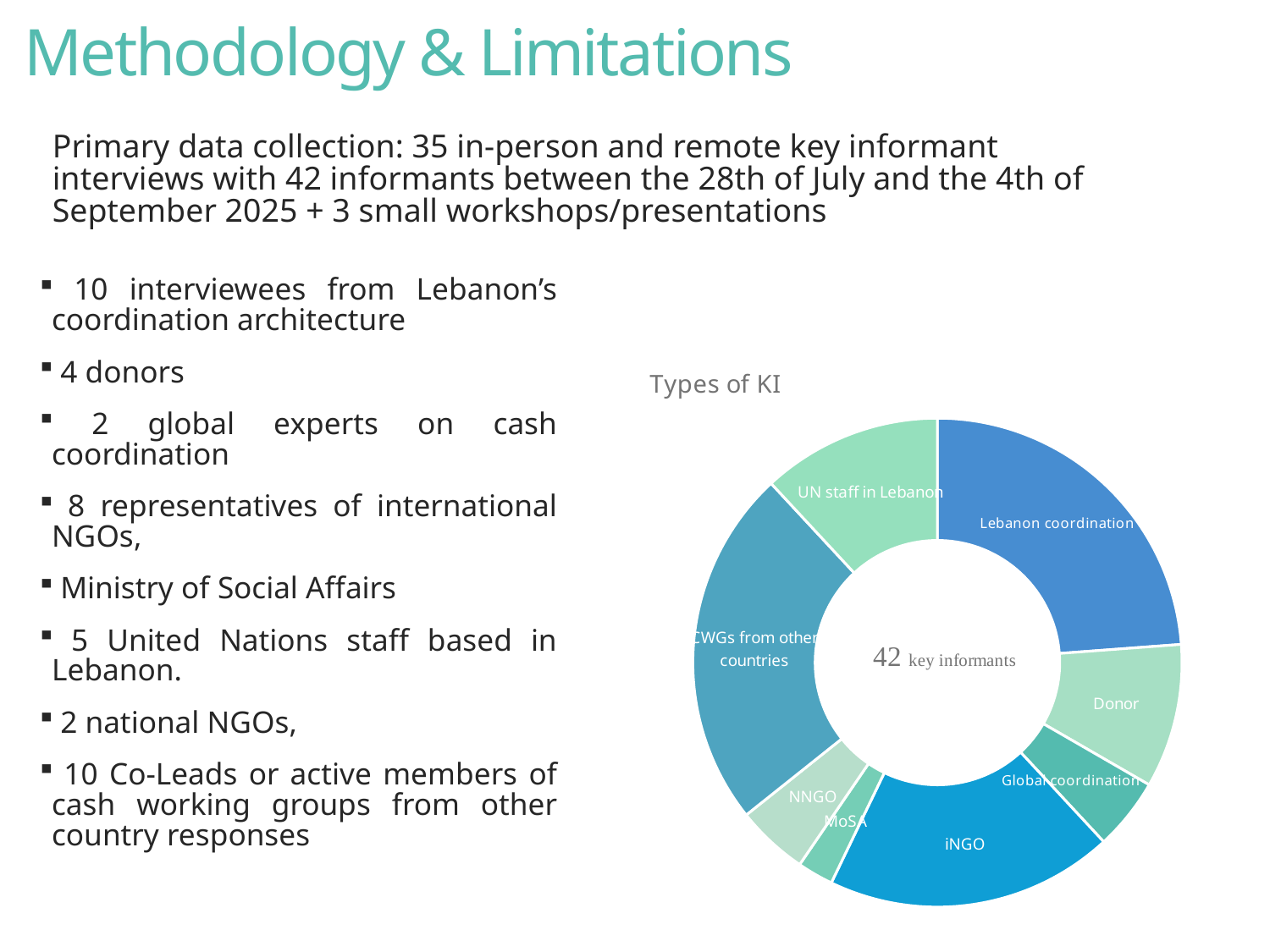
How many categories (slices) does the chart show? 8 Which slice is larger, UN staff in Lebanon or MoSA? UN staff in Lebanon Which slice is larger, CWGs from other countries or NNGO? CWGs from other countries What is the title of the chart? Types of KI What kind of chart is shown on the slide? Pie (donut) chart Which slice is larger, iNGO or Donor? iNGO What text is shown in the centre of the donut chart? 42 key informants Which category has the smallest slice in the chart? MoSA